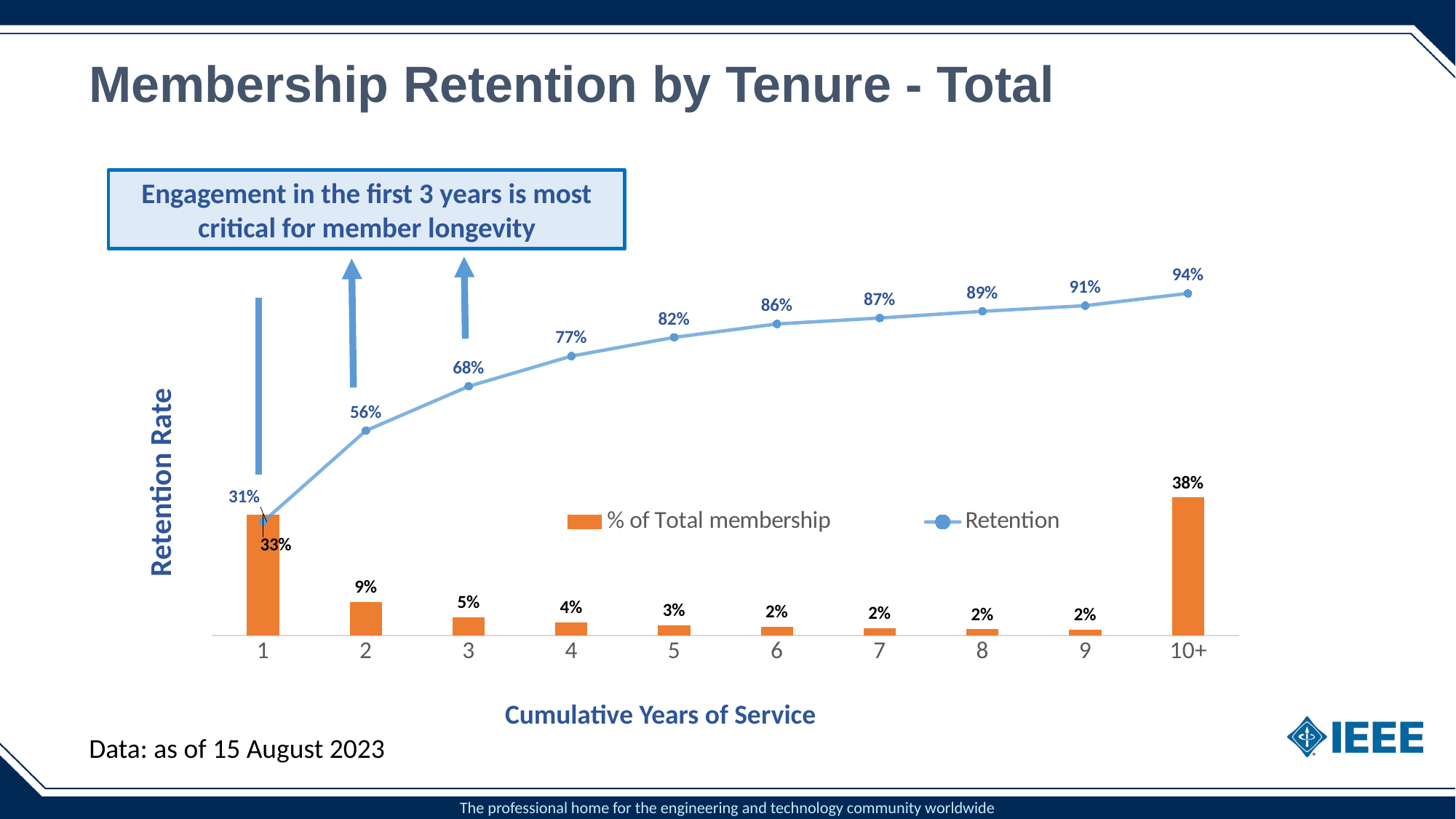
How many series does the legend list? 2 What is the difference between the Retention values for year 2 and year 1? 25% What is the title of the x axis? Cumulative Years of Service Which category has the lowest % of Total membership value? 6, 7, 8 and 9 (all 2%) What is the Retention value for year 3? 68% Does the Retention series rise or fall as cumulative years of service increase? rise Which is larger, the % of Total membership for year 1 or for year 10+? 10+ Which category has the highest Retention value? 10+ What is the % of Total membership value for year 10+? 38% What is the % of Total membership value for year 2? 9% What is the Retention value for year 1? 31% How many categories are shown on the x axis? 10